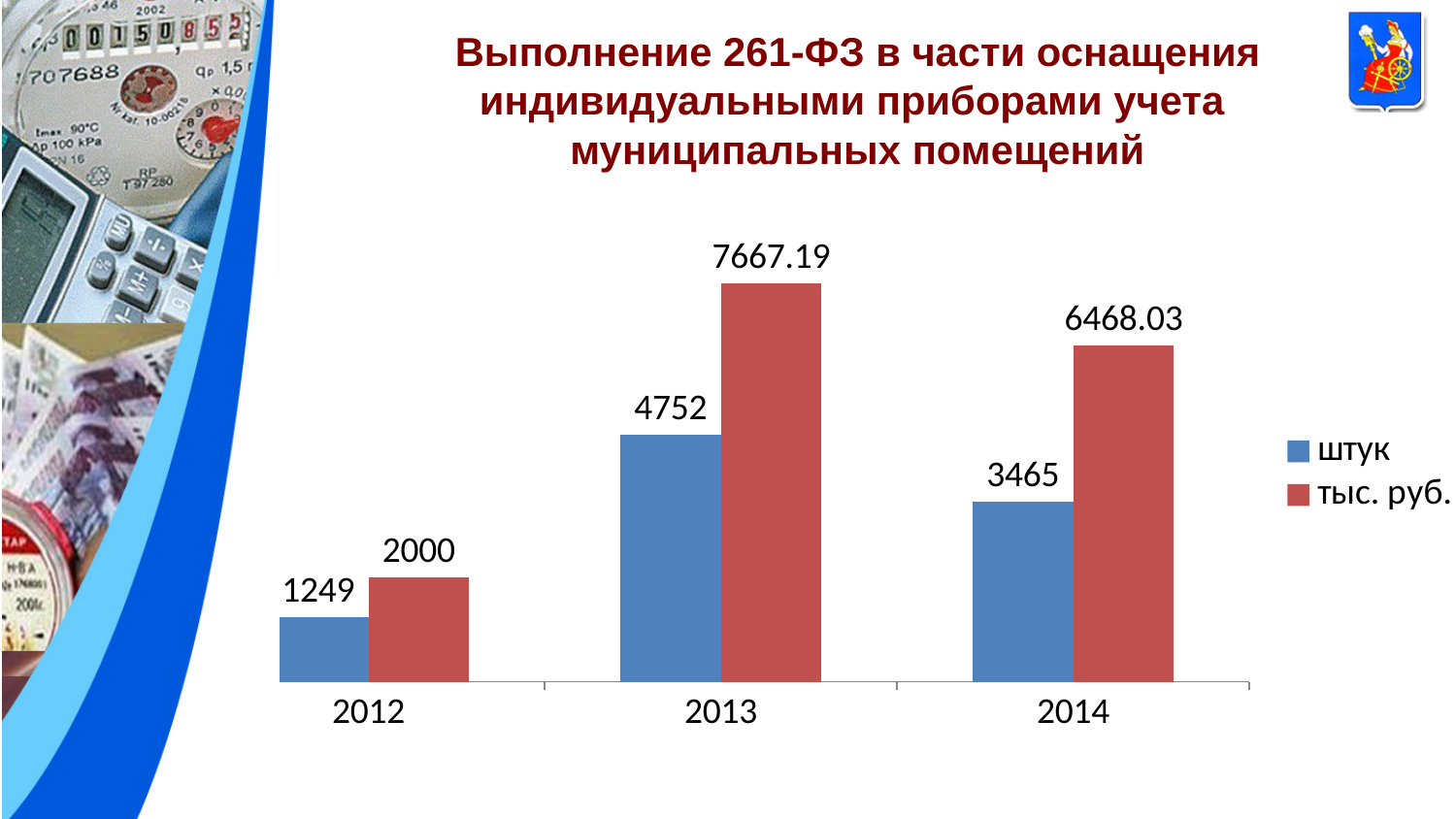
Which year has the highest value for the тыс. руб. series? 2013 How many years are shown on the x axis? 3 What kind of chart is shown on the slide? bar chart What is the value of the тыс. руб. series for 2014? 6468.03 How many series does the legend list? 2 What is the difference between the штук values for 2013 and 2014? 1287 Which colour represents the тыс. руб. series? red What is the value of the штук series for 2012? 1249 Which is larger: the тыс. руб. value for 2014 or for 2012? 2014 What is the value of the штук series for 2013? 4752 Which year has the lowest value for the штук series? 2012 What is the difference between the тыс. руб. values for 2013 and 2012? 5667.19